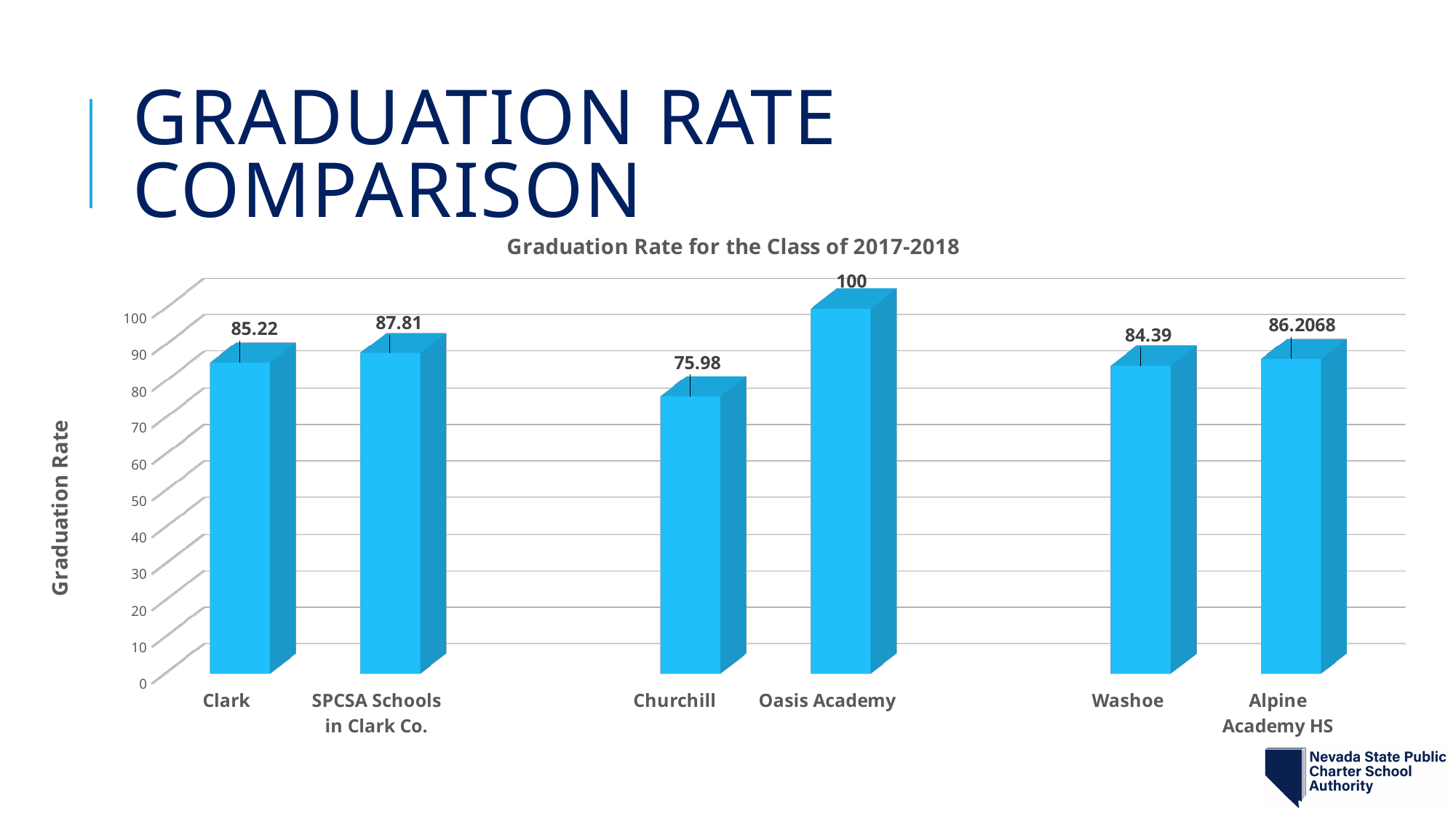
What is the graduation rate for Clark? 85.22 How many categories are shown on the chart? 6 What is the difference between the graduation rates of Oasis Academy and Churchill? 24.02 What is the difference between the graduation rates of SPCSA Schools in Clark Co. and Clark? 2.59 What is the graduation rate for SPCSA Schools in Clark Co.? 87.81 Which category has the lowest graduation rate? Churchill What kind of chart is shown on the slide? Bar chart What is the title of the chart? Graduation Rate for the Class of 2017-2018 Which category has the highest graduation rate? Oasis Academy What is the graduation rate for Churchill? 75.98 Which has a higher graduation rate, Washoe or Alpine Academy HS? Alpine Academy HS What is the graduation rate for Alpine Academy HS? 86.2068